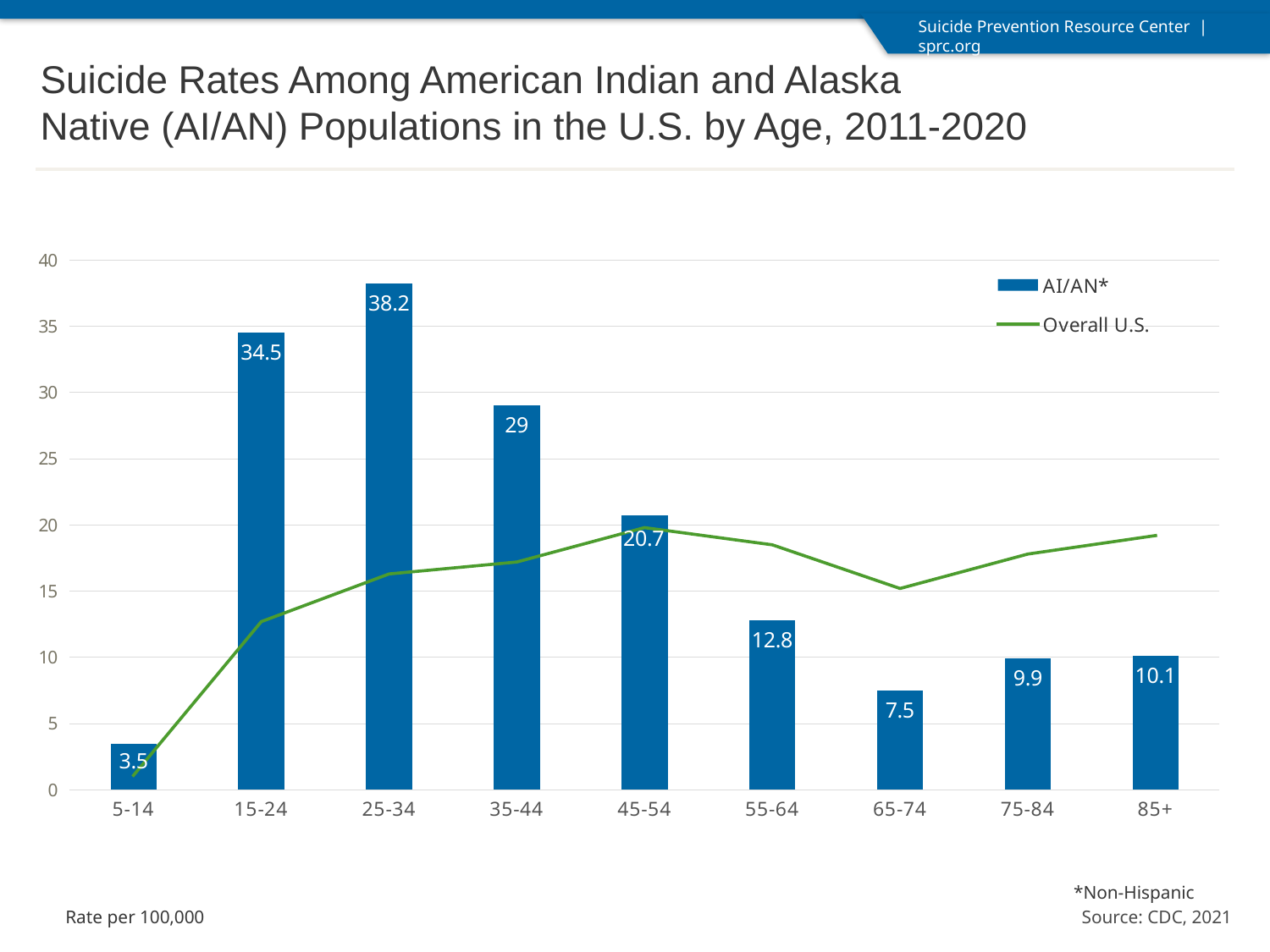
How many age groups are shown on the x axis? 9 Do the AI/AN* values rise or fall from the 25-34 age group to the 65-74 age group? fall What kind of chart is used to show the AI/AN* series? bar chart What is the AI/AN* suicide rate for the 85+ age group? 10.1 Is the Overall U.S. value for the 65-74 age group greater or less than 20? less What is the AI/AN* suicide rate for the 25-34 age group? 38.2 Which has a higher AI/AN* suicide rate, the 55-64 or the 75-84 age group? 55-64 What is the difference between the AI/AN* rates for the 25-34 and 15-24 age groups? 3.7 What is the AI/AN* suicide rate for the 65-74 age group? 7.5 How many series does the legend list? 2 Which age group has the lowest AI/AN* suicide rate? 5-14 Which age group has the highest AI/AN* suicide rate? 25-34